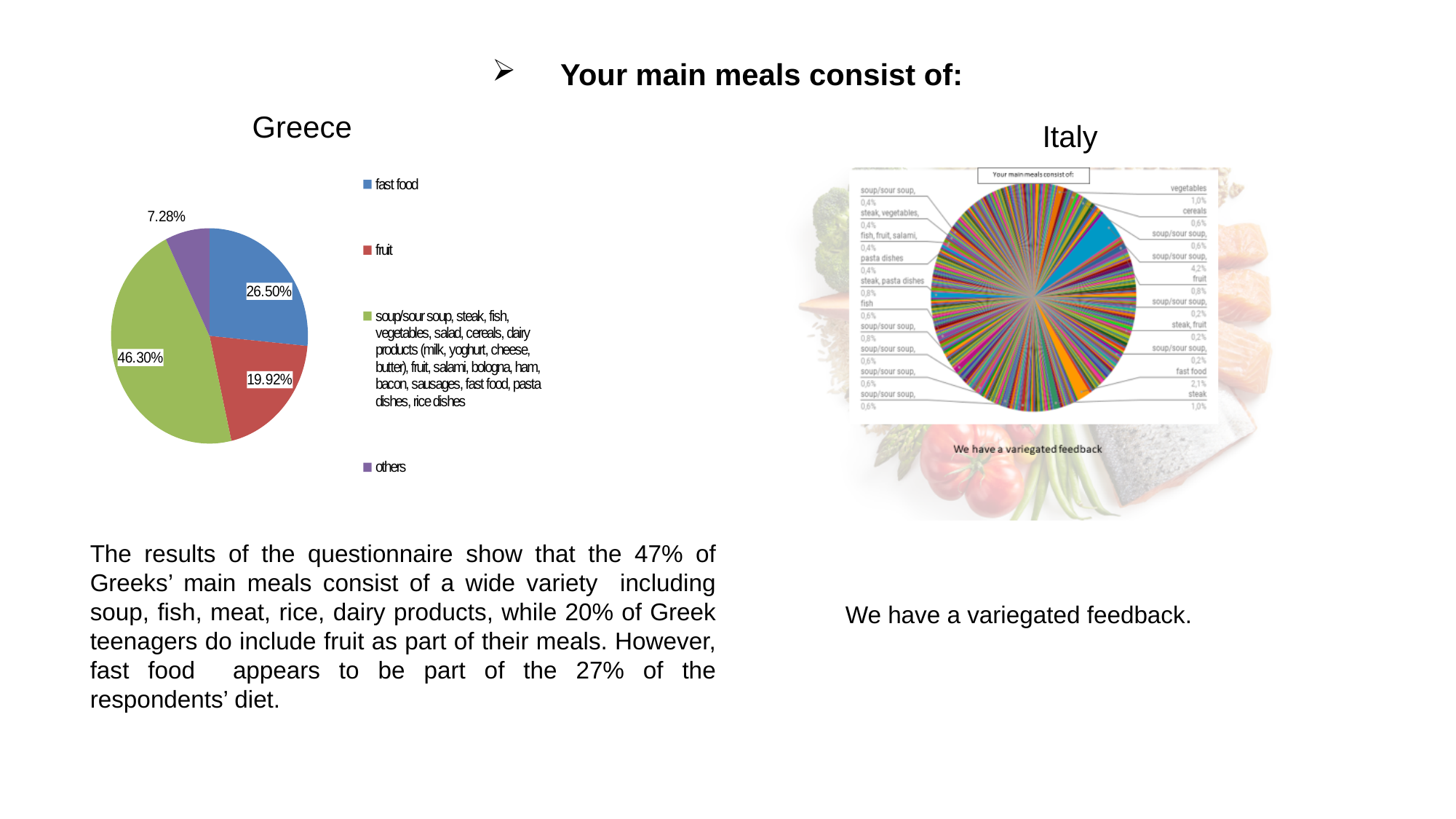
In the Greece chart, which category has the smallest slice? others In the Greece chart, which category has the largest slice? soup/sour soup, steak, fish, vegetables, salad, cereals, dairy products (milk, yoghurt, cheese, butter), fruit, salami, bologna, ham, bacon, sausages, fast food, pasta dishes, rice dishes What type of chart is the Greece chart? pie chart In the Greece chart, which is larger, the fast food slice or the fruit slice? fast food What is the title of the Italy chart? Your main meals consist of: In the Greece chart, what percentage is shown for fruit? 19.92% In the Greece chart, what percentage is shown for fast food? 26.50% What type of chart is the Italy chart? pie chart In the Greece chart, what colour is the slice for fruit? red In the Greece chart, what percentage is shown for others? 7.28% In the Greece chart, what is the difference between the fast food and fruit percentages? 6.58% How many categories does the legend of the Greece chart list? 4